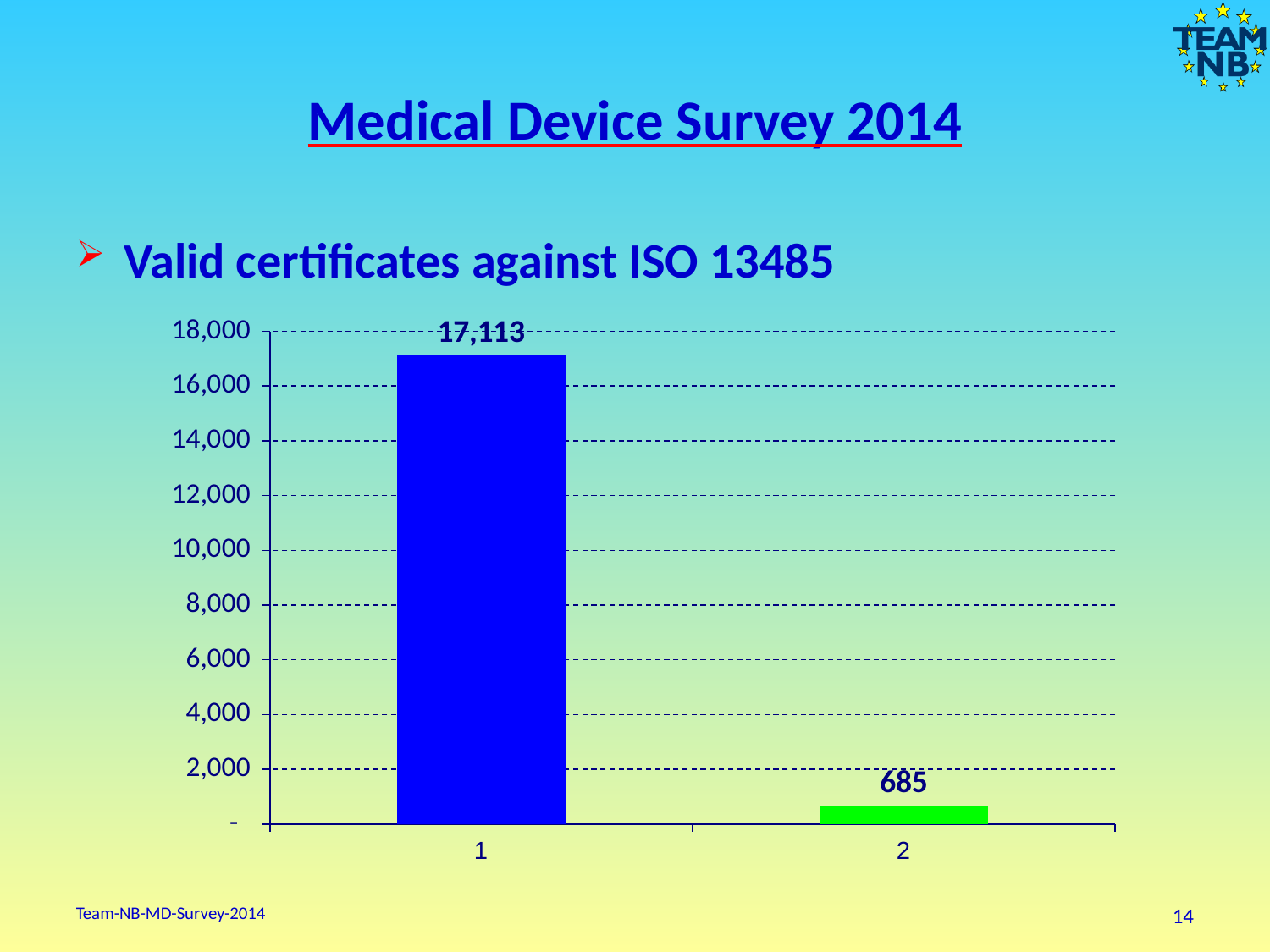
What kind of chart is shown on the slide? bar chart How many categories are shown on the x axis? 2 What is the difference between the values for category 1 and category 2? 16,428 What is the value for category 2? 685 Which is larger, the value for category 1 or category 2? 1 Is the value for category 1 greater or less than 16,000? greater Is the value for category 2 greater or less than 2,000? less What colour is the bar for category 2? green What is the total of the two bars? 17,798 What is the value for category 1? 17,113 Which category has the highest value? 1 Which category has the lowest value? 2